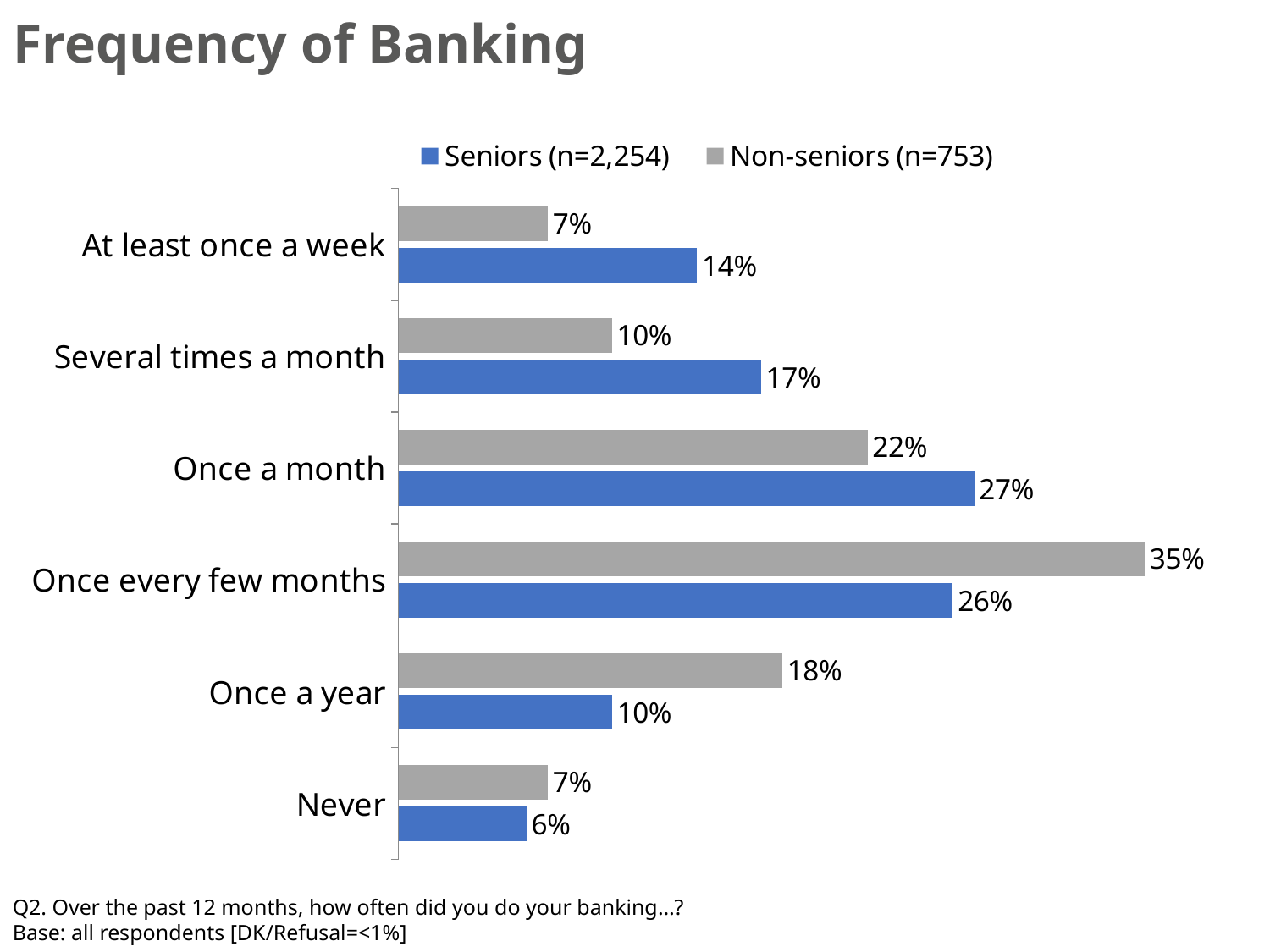
What is the difference between Non-seniors and Seniors for Once a year? 8% What kind of chart is shown on the slide? Bar chart How many frequency categories are shown on the chart? 6 What percentage of Seniors bank at least once a week? 14% How many series does the legend list? 2 What percentage of Seniors bank once a year? 10% Which group has the larger value for Once a month, Seniors or Non-seniors? Seniors Which category has the highest value for Non-seniors? Once every few months What is the sample size for Non-seniors shown in the legend? 753 Which category has the lowest value for Seniors? Never Which colour represents Seniors in the chart? Blue What percentage of Non-seniors bank once every few months? 35%